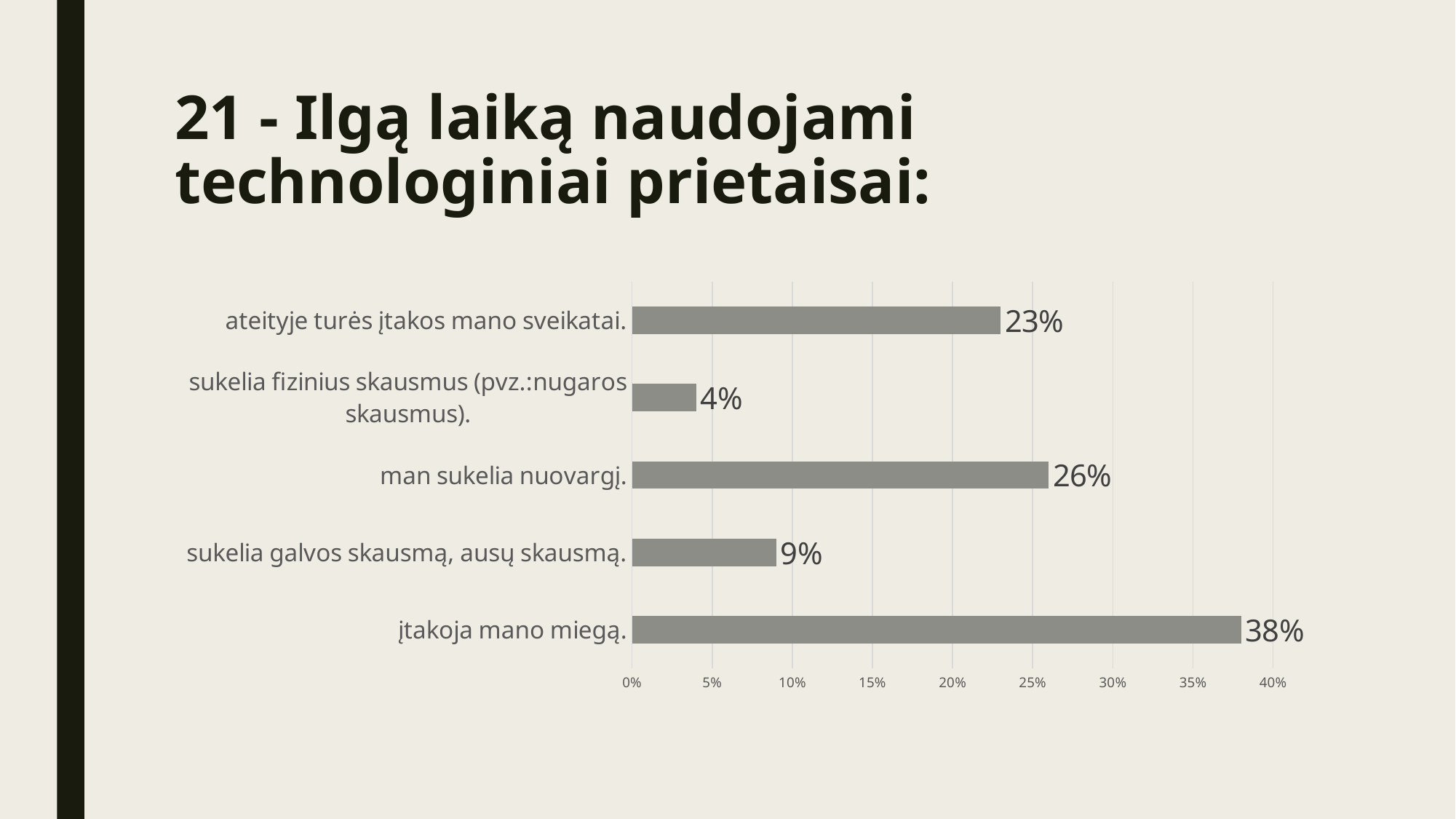
Which is larger: the value for "man sukelia nuovargį." or the value for "ateityje turės įtakos mano sveikatai."? man sukelia nuovargį. What kind of chart is shown on the slide? bar chart What is the value for "įtakoja mano miegą."? 38% Is the value for "ateityje turės įtakos mano sveikatai." greater or less than 20%? greater Which category has the lowest value? sukelia fizinius skausmus (pvz.:nugaros skausmus). Which category has the highest value? įtakoja mano miegą. What is the difference between the values for "įtakoja mano miegą." and "ateityje turės įtakos mano sveikatai."? 15% What is the title of the slide? 21 - Ilgą laiką naudojami technologiniai prietaisai: What is the value for "sukelia fizinius skausmus (pvz.:nugaros skausmus)."? 4% What is the value for "man sukelia nuovargį."? 26% How many categories are shown in the chart? 5 What is the value for "sukelia galvos skausmą, ausų skausmą."? 9%